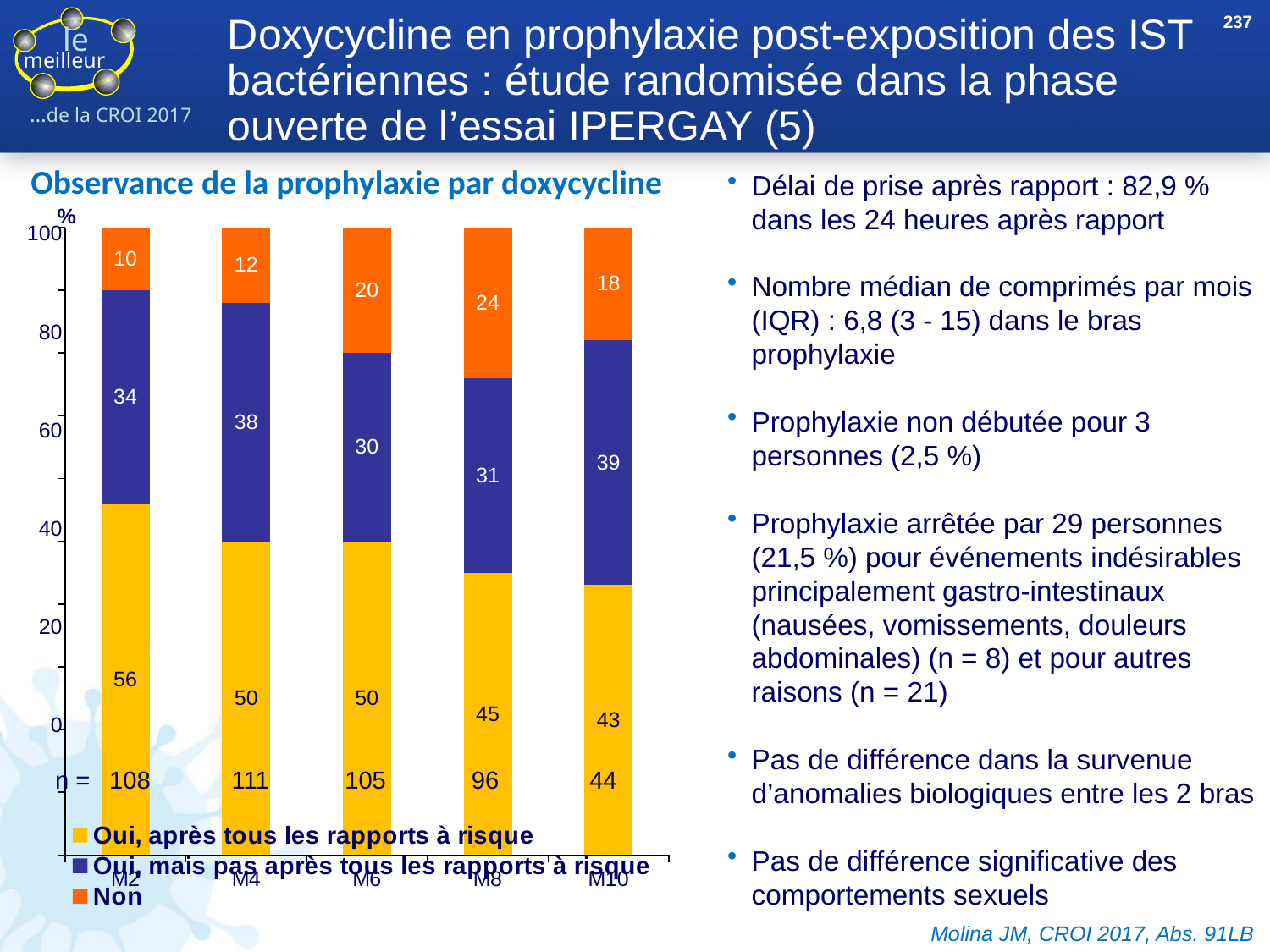
What kind of chart is shown under the title "Observance de la prophylaxie par doxycycline"? stacked bar chart At which time point is the "Oui, après tous les rapports à risque" value lowest? M10 What is the difference between the "Non" values at M6 and M2? 10 At which time point is the "Non" value highest? M8 Does the "Oui, après tous les rapports à risque" value rise or fall from M2 to M10? fall What is the value of "Oui, après tous les rapports à risque" at M2? 56 What is the value of "Non" at M8? 24 What is the n value shown below the M10 bar? 44 How many series does the legend of the chart list? 3 Which is larger: the "Oui, mais pas après tous les rapports à risque" value at M4 or at M6? M4 What is the value of "Oui, mais pas après tous les rapports à risque" at M10? 39 How many time points (categories) are shown on the x axis of the chart? 5